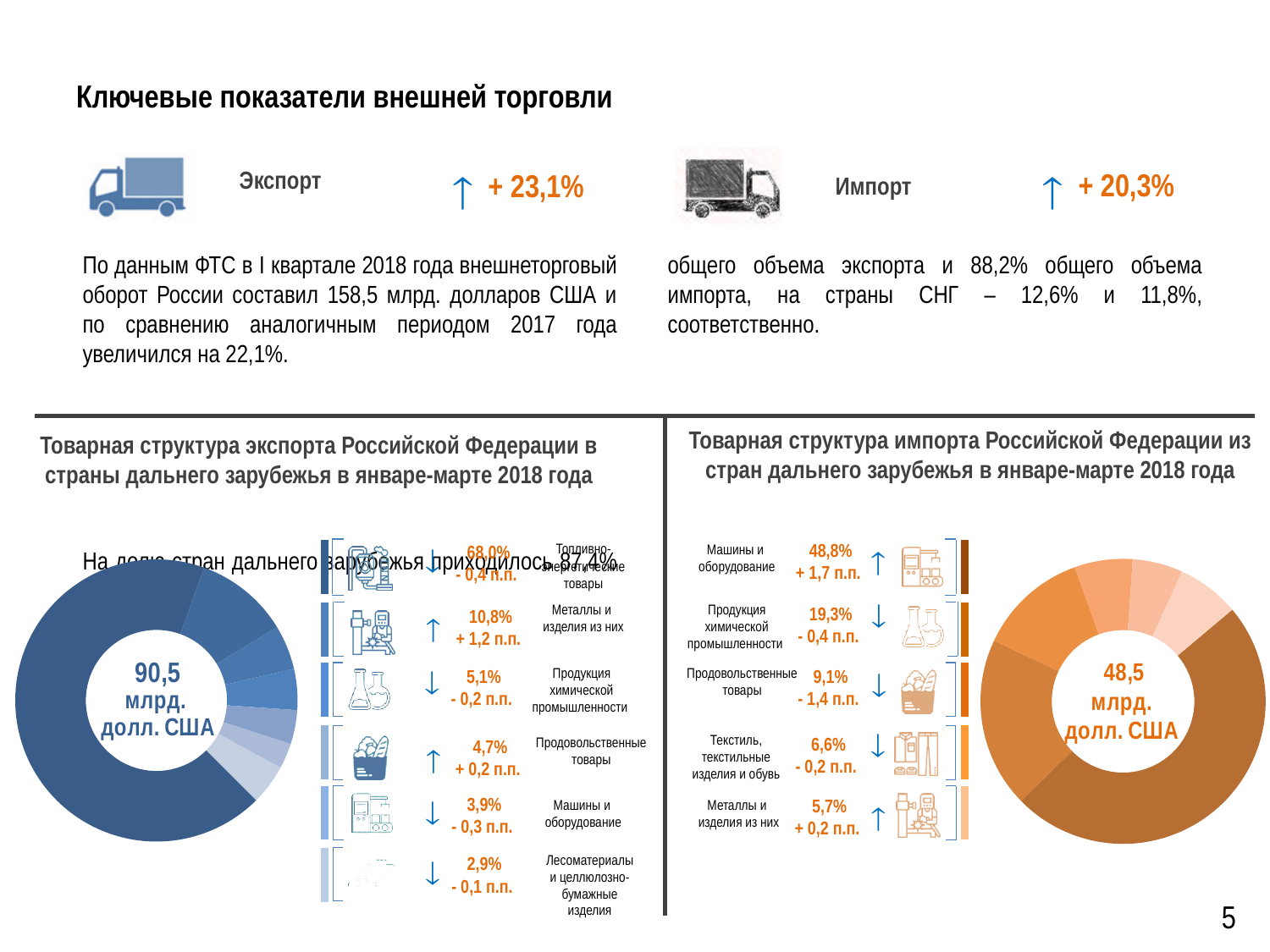
On the import structure chart (right), which listed category has the smallest share? Металлы и изделия из них On the import structure chart (right), what is the difference in share between Машины и оборудование and Продукция химической промышленности? 29,5 п.п. How many product categories are listed for the export structure chart (left)? 6 On the export structure chart (left), what share do Металлы и изделия из них account for? 10,8% On the import structure chart (right), what total value is shown in the centre of the donut? 48,5 млрд. долл. США On the import structure chart (right), what is the change in percentage points shown for Продукция химической промышленности? - 0,4 п.п. On the export structure chart (left), what is the change in percentage points shown for Лесоматериалы и целлюлозно-бумажные изделия? - 0,1 п.п. How many product categories are listed for the import structure chart (right)? 5 On the export structure chart (left), which has the larger share: Продовольственные товары or Машины и оборудование? Продовольственные товары On the export structure chart (left), what total value is shown in the centre of the donut? 90,5 млрд. долл. США What kind of chart is used to show the export structure on the left? doughnut chart On the import structure chart (right), what share do Машины и оборудование account for? 48,8%